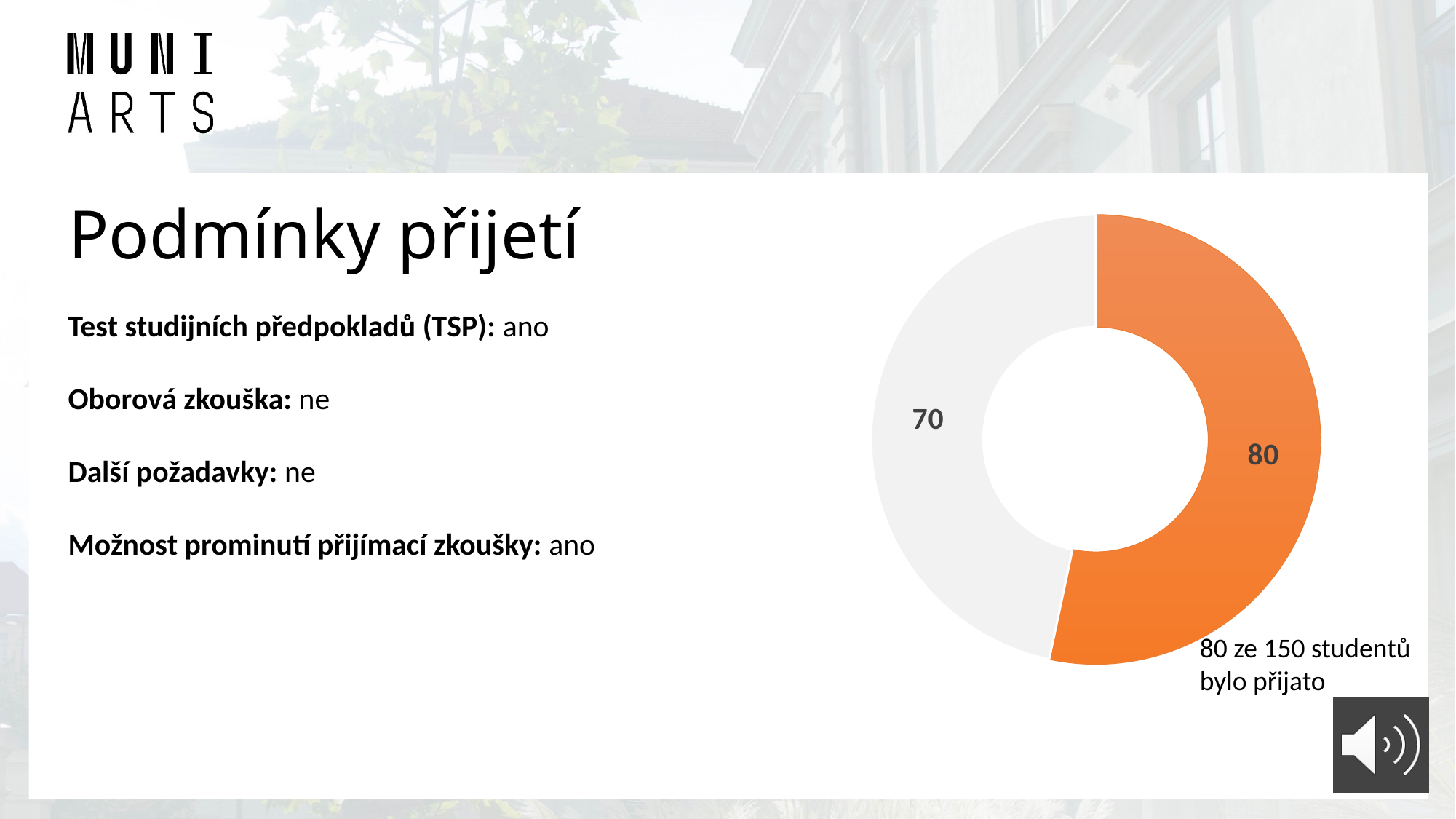
What value is shown on the orange slice of the doughnut chart? 80 Which slice of the doughnut chart has the larger value? The orange slice (80) What is the total of the two slice values in the doughnut chart? 150 What does the annotation below the orange slice say? 80 ze 150 studentů bylo přijato Is the value of the orange slice larger or smaller than the value of the grey slice? Larger What kind of chart is shown on the slide? Doughnut (pie) chart How many slices does the doughnut chart have? 2 What is the difference between the values of the orange and grey slices? 10 What value is shown on the grey slice of the doughnut chart? 70 What colour is the slice representing the accepted students? Orange According to the annotation next to the chart, how many of the 150 students were accepted? 80 Which slice of the doughnut chart has the smaller value? The grey slice (70)